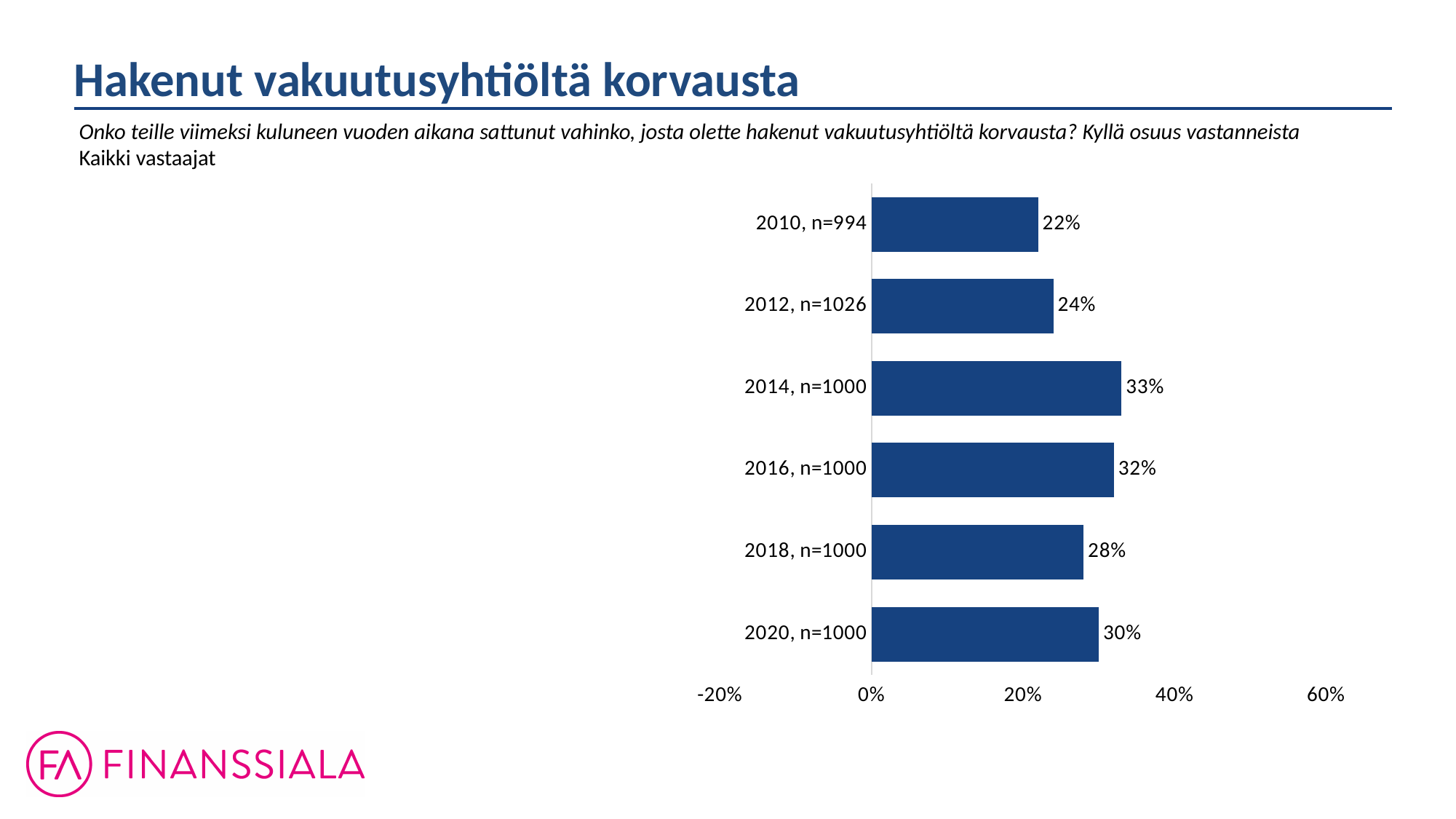
What is the value for 2020, n=1000? 30% Which category has the lowest value? 2010, n=994 What is the difference between the values for 2014, n=1000 and 2010, n=994? 11% What is the difference between the values for 2020, n=1000 and 2018, n=1000? 2% How many categories are shown in the chart? 6 Is the value for 2016, n=1000 greater or less than 20%? greater Which is larger, the value for 2012, n=1026 or the value for 2018, n=1000? 2018, n=1000 What is the value for 2018, n=1000? 28% What is the title of the slide? Hakenut vakuutusyhtiöltä korvausta Which category has the highest value? 2014, n=1000 What kind of chart is shown on the slide? bar chart What is the value for 2010, n=994? 22%